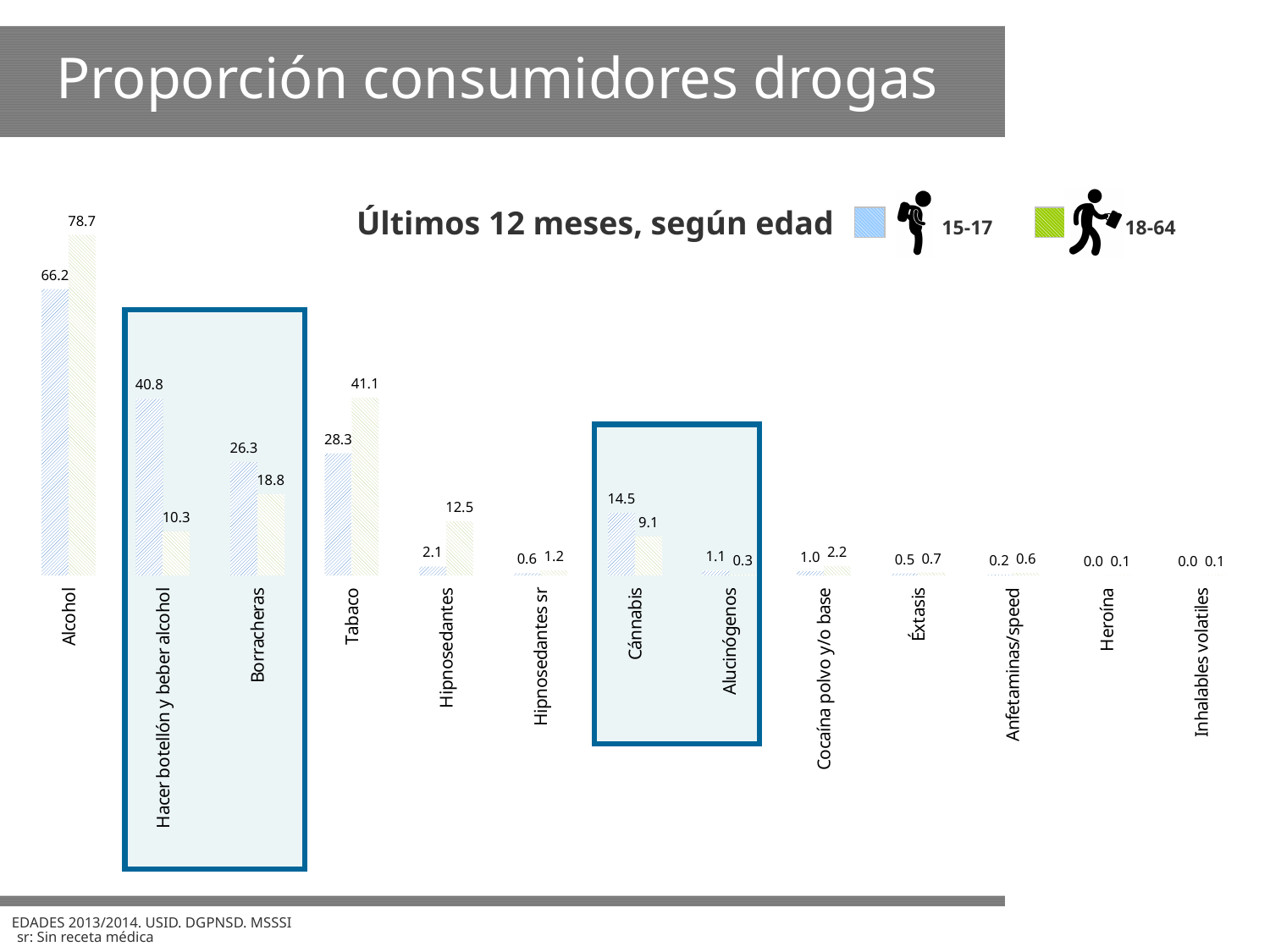
Which is larger for Borracheras, the 15-17 value or the 18-64 value? 15-17 Which category has the highest value in the 15-17 series? Alcohol What is the value for Cánnabis in the 15-17 series? 14.5 What kind of chart is shown on the slide? Bar chart What is the value for Alcohol in the 18-64 series? 78.7 Which is larger for Tabaco, the 15-17 value or the 18-64 value? 18-64 How many series does the legend list? 2 What is the value for Tabaco in the 18-64 series? 41.1 What is the difference between the 15-17 and 18-64 values for Hacer botellón y beber alcohol? 30.5 What is the subtitle shown above the chart? Últimos 12 meses, según edad What is the value for Hipnosedantes in the 15-17 series? 2.1 How many categories are shown on the x axis? 13